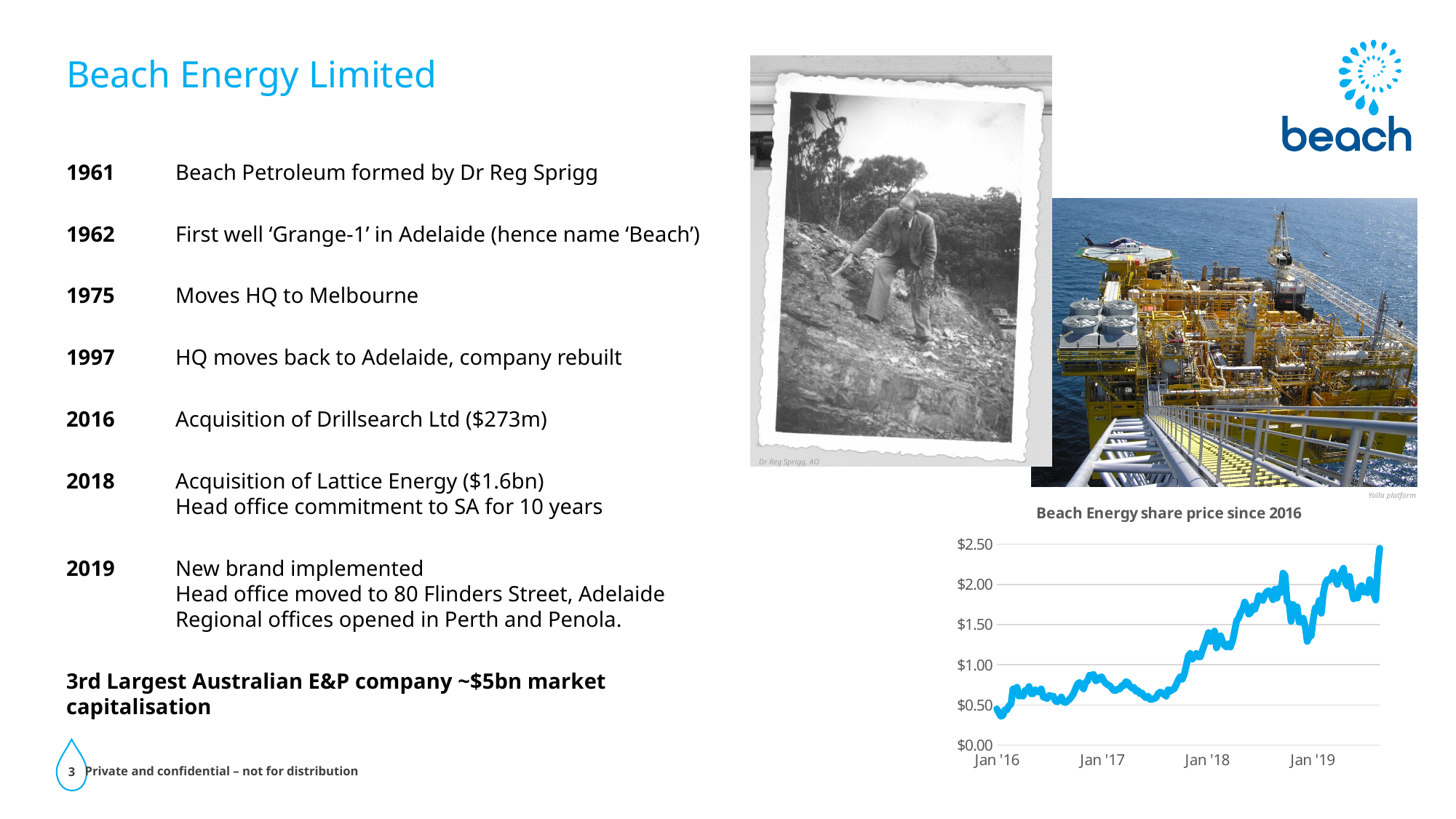
Is the share price at the end of the series (2019) greater or less than $2.00? greater Is the share price at Jan '17 greater or less than $0.50? greater Is the share price at Jan '17 greater or less than $1.00? less In which year does the share price reach its highest point in the chart? 2019 How many year labels are shown on the x axis of the chart? 4 What is the title of the chart on the slide? Beach Energy share price since 2016 What kind of chart is shown on the slide? line chart What is the highest value shown on the y axis of the chart? $2.50 Does the share price generally rise or fall from Jan '16 to 2019 in the chart? rise Which is higher, the share price at Jan '17 or at Jan '18? Jan '18 Which is higher, the share price at Jan '16 or at Jan '19? Jan '19